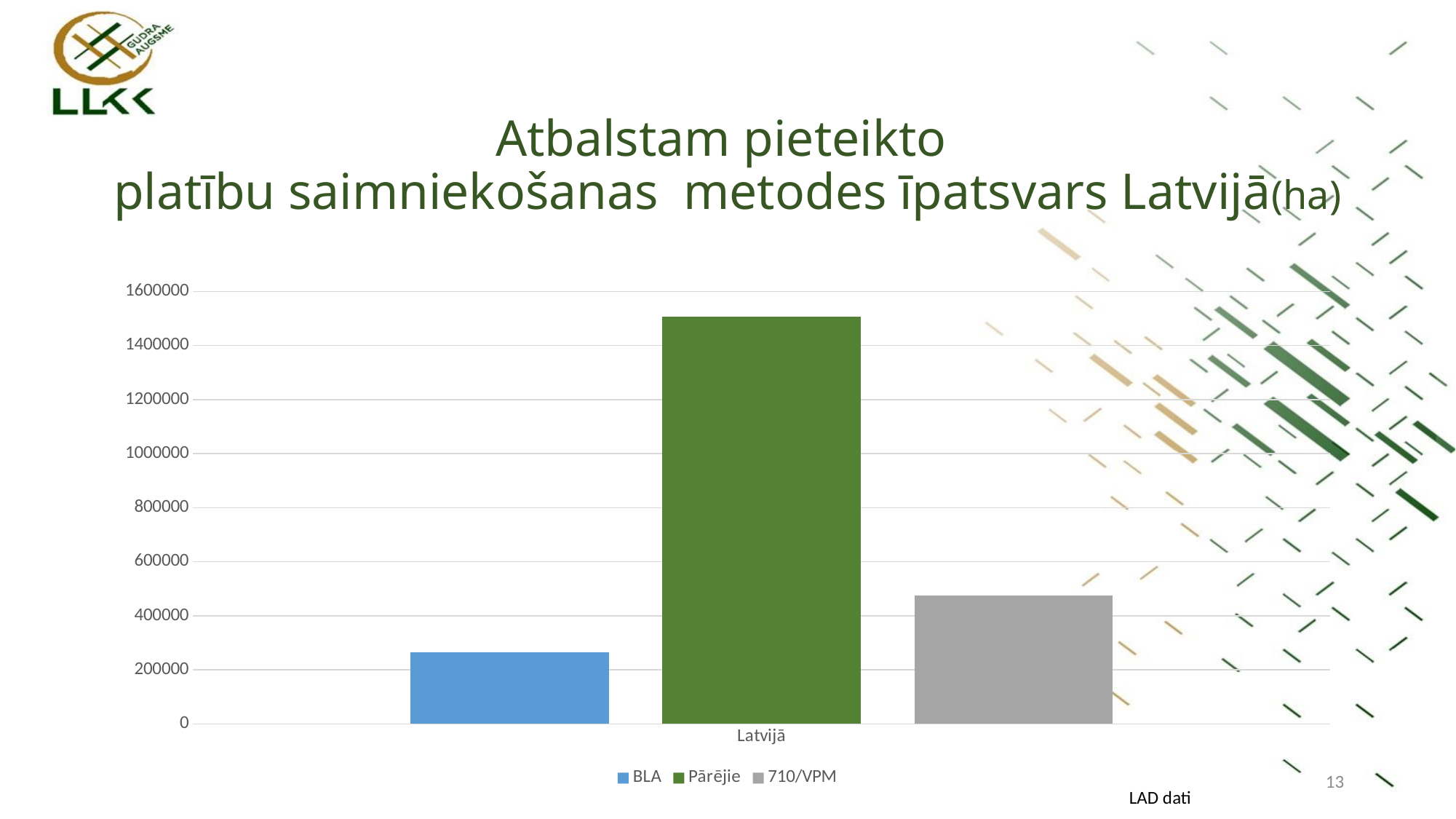
Is the value for 710/VPM greater or less than 400000? greater How many categories are shown on the x axis? 1 Is the value for BLA greater or less than 400000? less Which is larger, the value for Pārējie or the value for 710/VPM? Pārējie Which is larger, the value for BLA or the value for 710/VPM? 710/VPM How many series does the legend list? 3 Which series has the highest value? Pārējie Is the value for Pārējie greater or less than 1400000? greater What kind of chart is shown on the slide? bar chart What colour is the bar for the Pārējie series? green What is the label of the single category on the x axis? Latvijā Which series has the lowest value? BLA